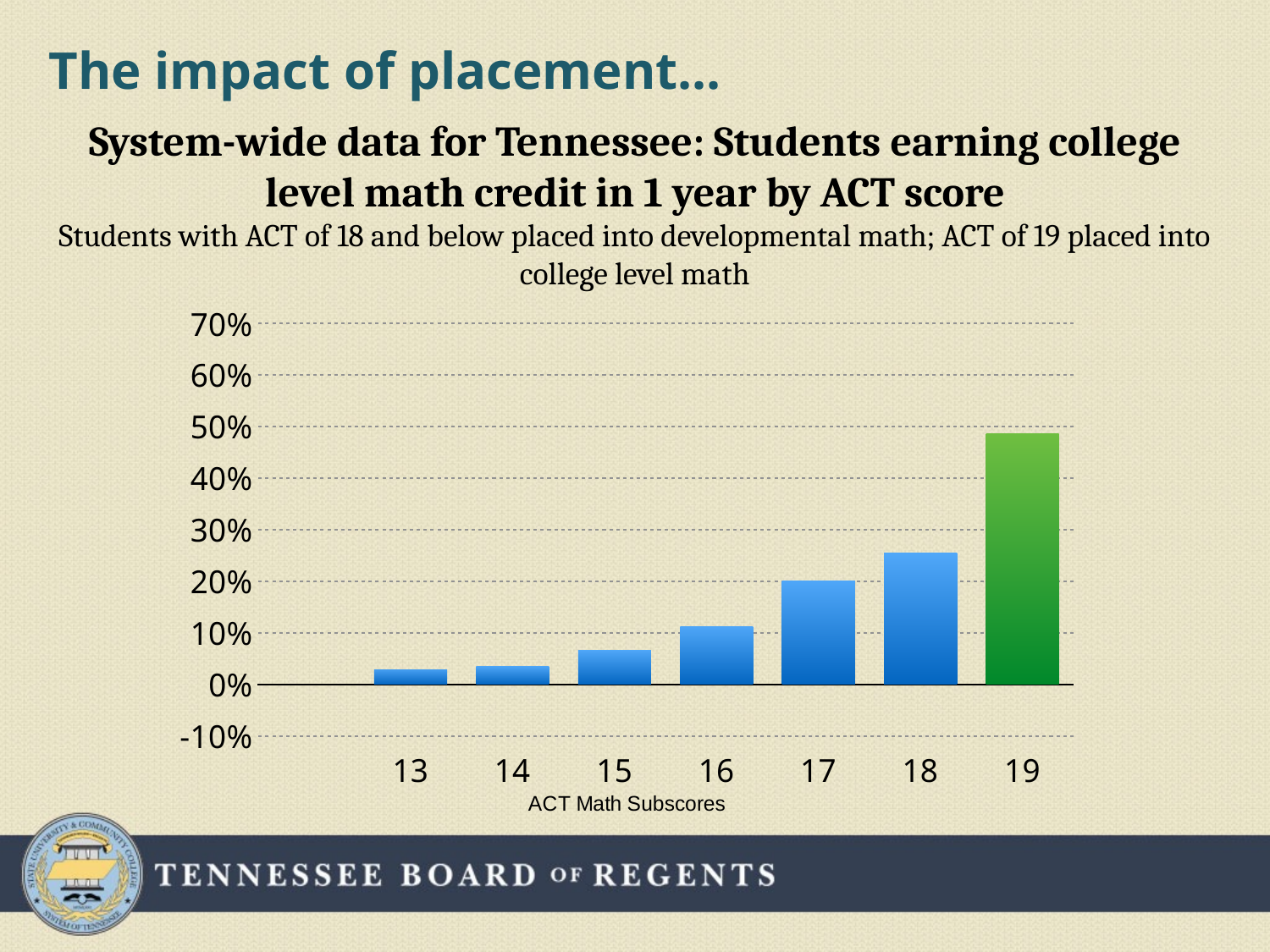
Is the value for ACT score 19 greater or less than 50%? less Which ACT Math Subscore has the highest percentage of students earning college level math credit? 19 What colour is the bar for ACT score 19? green Which has a larger value, ACT score 18 or ACT score 19? 19 What is the title of the horizontal axis? ACT Math Subscores Is the value for ACT score 19 greater or less than 40%? greater Do the values rise or fall as the ACT Math Subscore increases from 13 to 19? rise Is the value for ACT score 15 greater or less than 10%? less What kind of chart is shown on the slide? bar chart How many ACT Math Subscore categories are plotted on the chart? 7